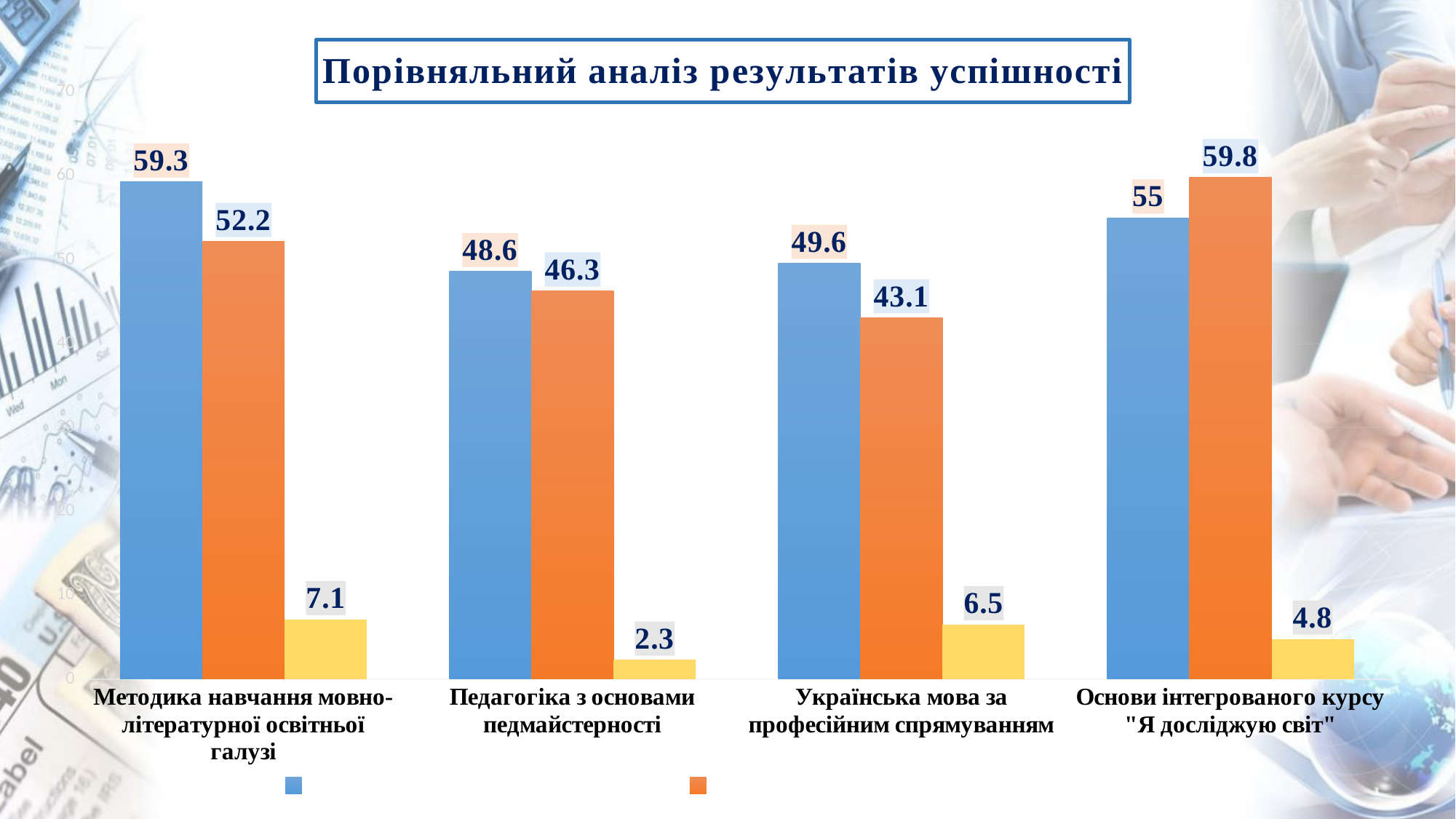
What is the value of the yellow bar for "Основи інтегрованого курсу "Я досліджую світ""? 4.8 Which category has the highest blue bar? Методика навчання мовно-літературної освітньої галузі How many categories are shown on the x axis of the chart? 4 Which category has the highest orange bar? Основи інтегрованого курсу "Я досліджую світ" What type of chart is shown on the slide? bar chart Is the blue bar for "Українська мова за професійним спрямуванням" greater or less than 40? greater What is the title of the chart? Порівняльний аналіз результатів успішності What is the value of the blue bar for "Педагогіка з основами педмайстерності"? 48.6 For "Основи інтегрованого курсу "Я досліджую світ"", which bar is larger, the blue or the orange? orange Which category has the lowest yellow bar? Педагогіка з основами педмайстерності What is the value of the orange bar for "Українська мова за професійним спрямуванням"? 43.1 What is the difference between the blue and orange bars for "Методика навчання мовно-літературної освітньої галузі"? 7.1